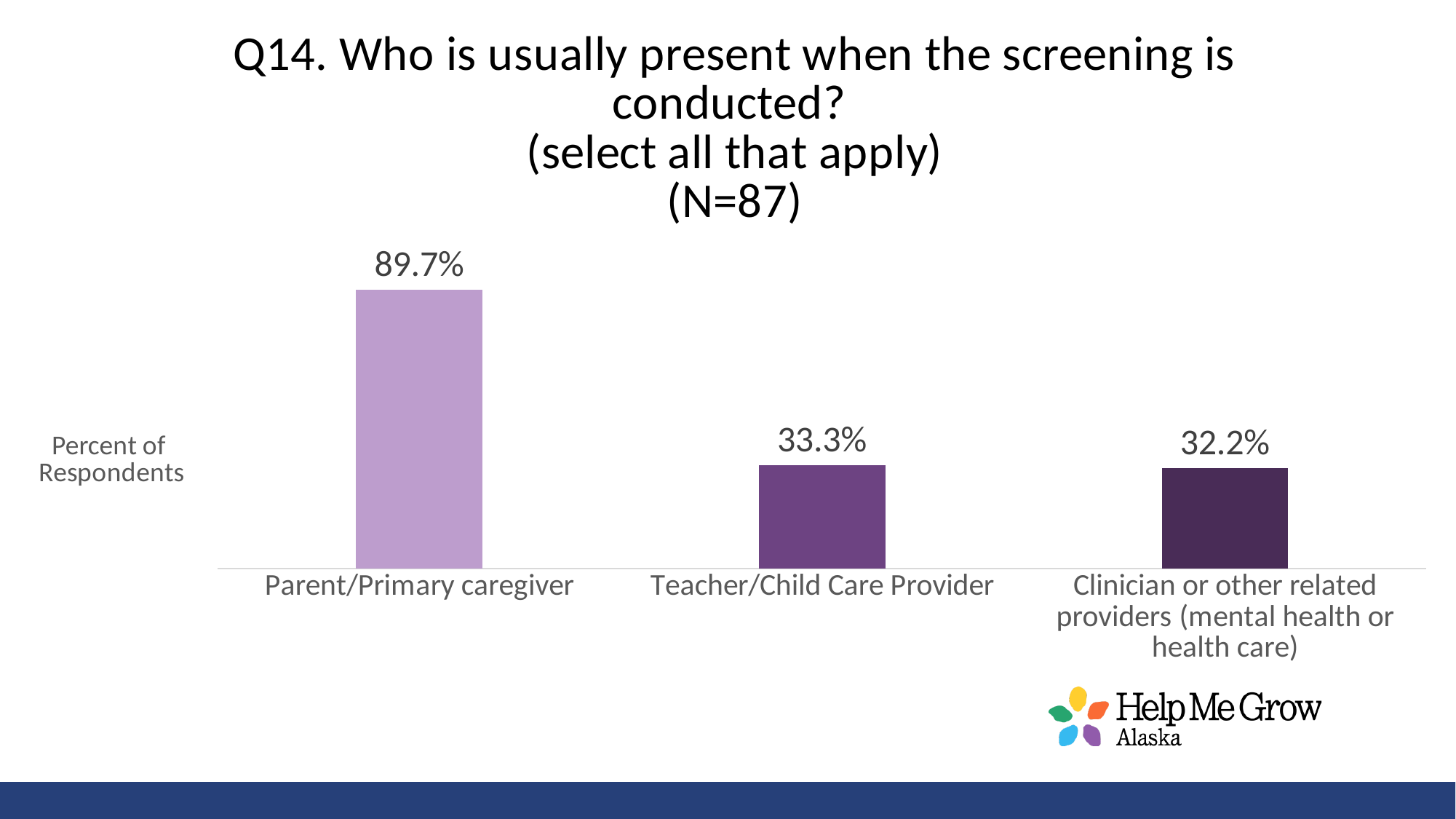
What is the difference in percentage points between Teacher/Child Care Provider and Clinician or other related providers? 1.1 What percentage of respondents selected Parent/Primary caregiver? 89.7% What is the difference in percentage points between Parent/Primary caregiver and Teacher/Child Care Provider? 56.4 How many categories are shown in the chart? 3 What percentage of respondents selected Clinician or other related providers (mental health or health care)? 32.2% Which category has the lowest percentage of respondents? Clinician or other related providers (mental health or health care) Which is larger: the value for Parent/Primary caregiver or the value for Teacher/Child Care Provider? Parent/Primary caregiver What is the sample size (N) stated in the chart title? 87 Which category has the highest percentage of respondents? Parent/Primary caregiver What is the label on the vertical axis of the chart? Percent of Respondents What kind of chart is shown on the slide? Bar chart What percentage of respondents selected Teacher/Child Care Provider? 33.3%